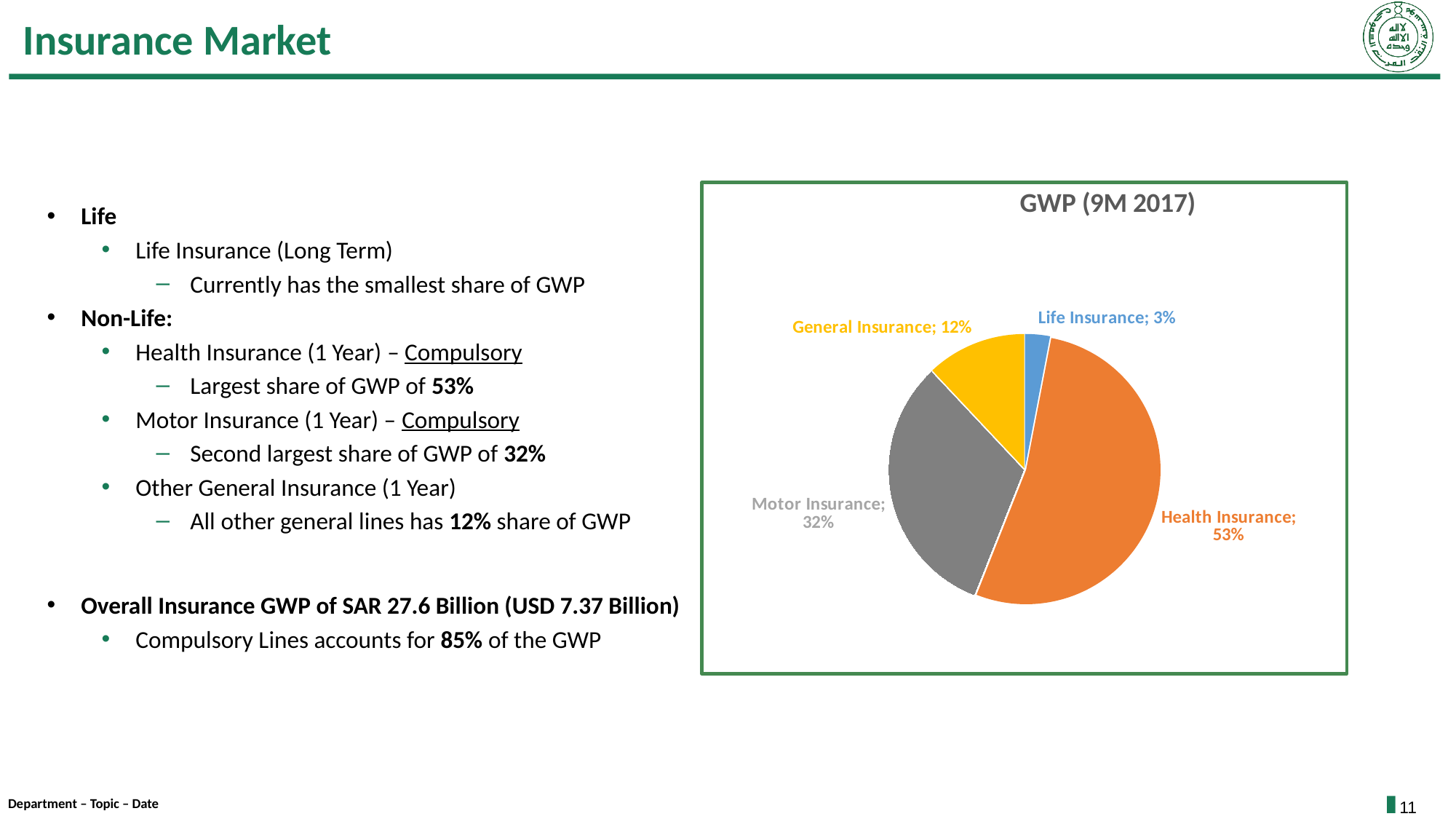
What share of GWP does Life Insurance have in the chart? 3% What kind of chart is shown on the slide? pie chart Which is larger, the General Insurance share or the Life Insurance share? General Insurance Which category has the smallest slice of the pie? Life Insurance What share of GWP does Health Insurance have in the chart? 53% Which category has the largest slice of the pie? Health Insurance How many slices does the pie chart have? 4 What is the title of the chart? GWP (9M 2017) What colour is the Motor Insurance slice? grey What share of GWP does General Insurance have in the chart? 12% What share of GWP does Motor Insurance have in the chart? 32% What is the difference in percentage points between the Health Insurance and Motor Insurance shares? 21